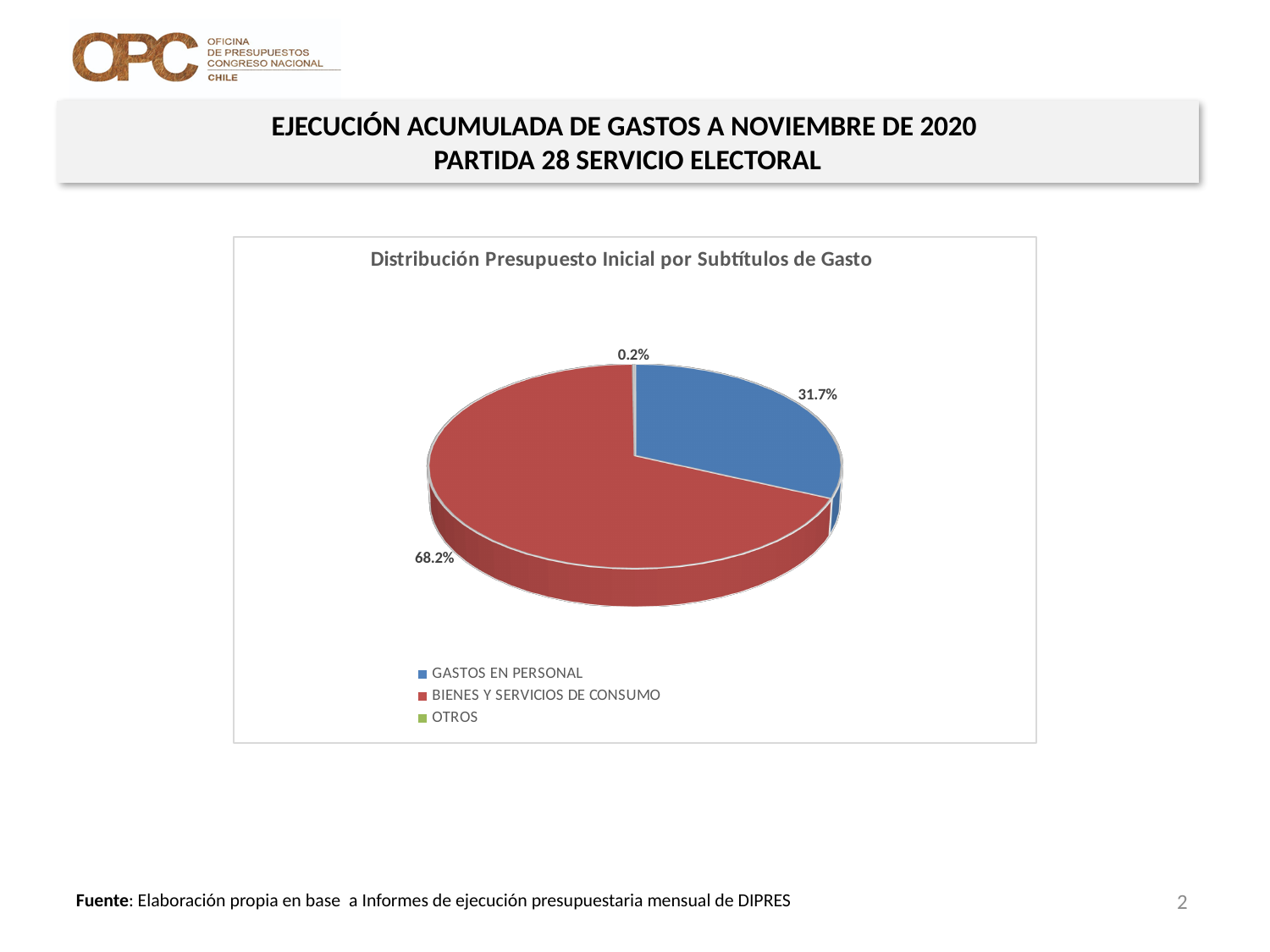
What is the title of the chart? Distribución Presupuesto Inicial por Subtítulos de Gasto What is the difference in percentage points between BIENES Y SERVICIOS DE CONSUMO and GASTOS EN PERSONAL? 36.5 Which is larger, the share for GASTOS EN PERSONAL or the share for OTROS? GASTOS EN PERSONAL What colour is the slice for GASTOS EN PERSONAL? Blue How many categories does the legend list? 3 What share of the pie does BIENES Y SERVICIOS DE CONSUMO represent? 68.2% Which category has the smallest slice of the pie? OTROS What kind of chart is shown on the slide? Pie chart What share of the pie does GASTOS EN PERSONAL represent? 31.7% Which category has the largest slice of the pie? BIENES Y SERVICIOS DE CONSUMO What share of the pie does OTROS represent? 0.2%